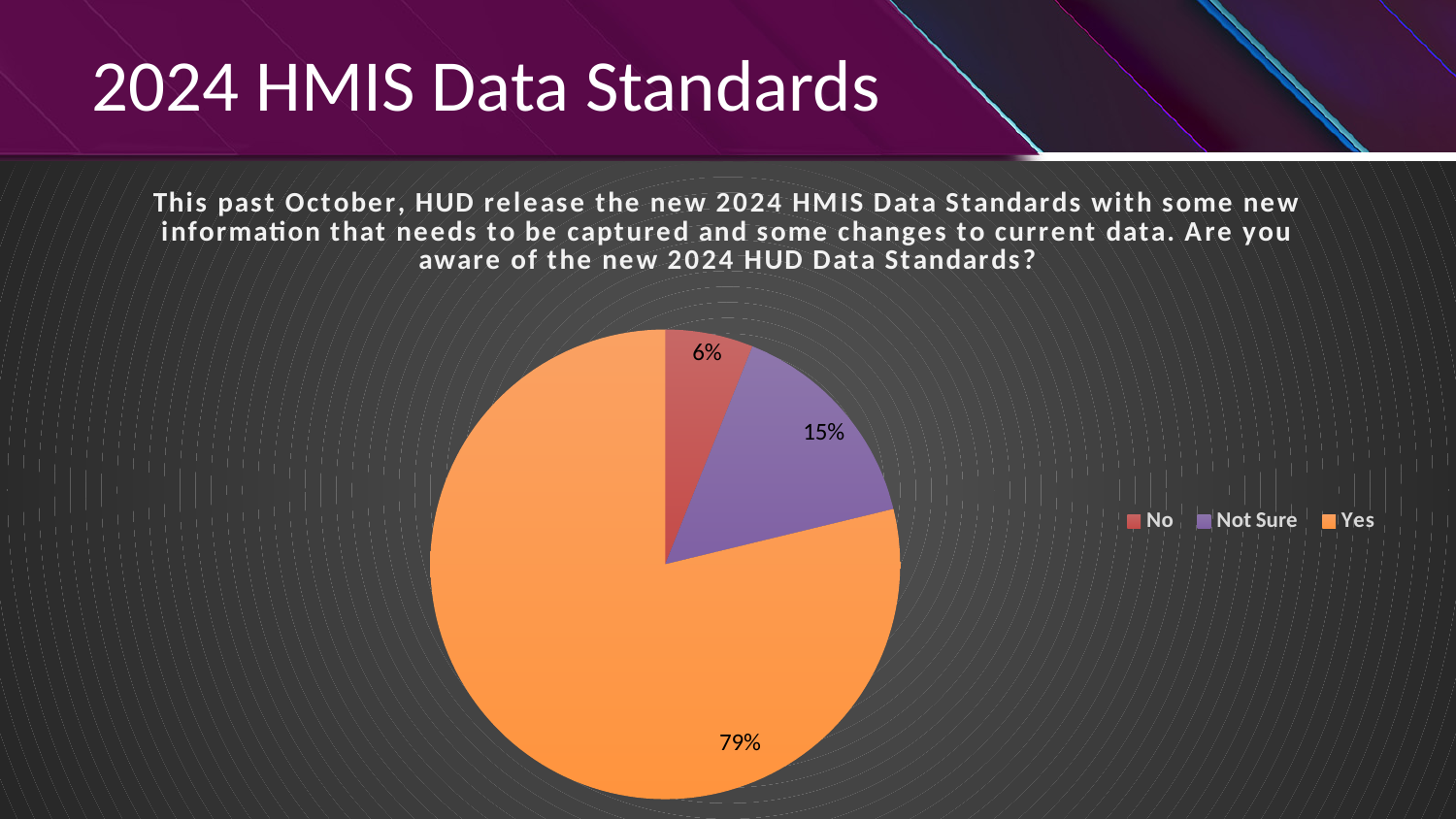
What is the difference in percentage points between the "Yes" and "Not Sure" slices? 64 What percentage of respondents answered "Not Sure"? 15% Which is larger, the "Not Sure" slice or the "No" slice? Not Sure What colour is the "Yes" slice in the pie chart? orange Which response has the largest share of the pie? Yes What percentage of respondents answered "Yes"? 79% How many entries does the legend list? 3 What percentage of respondents answered "No"? 6% Which response has the smallest share of the pie? No What kind of chart is shown on the slide? pie chart What is the difference in percentage points between the "Not Sure" and "No" slices? 9 How many slices does the pie chart have? 3